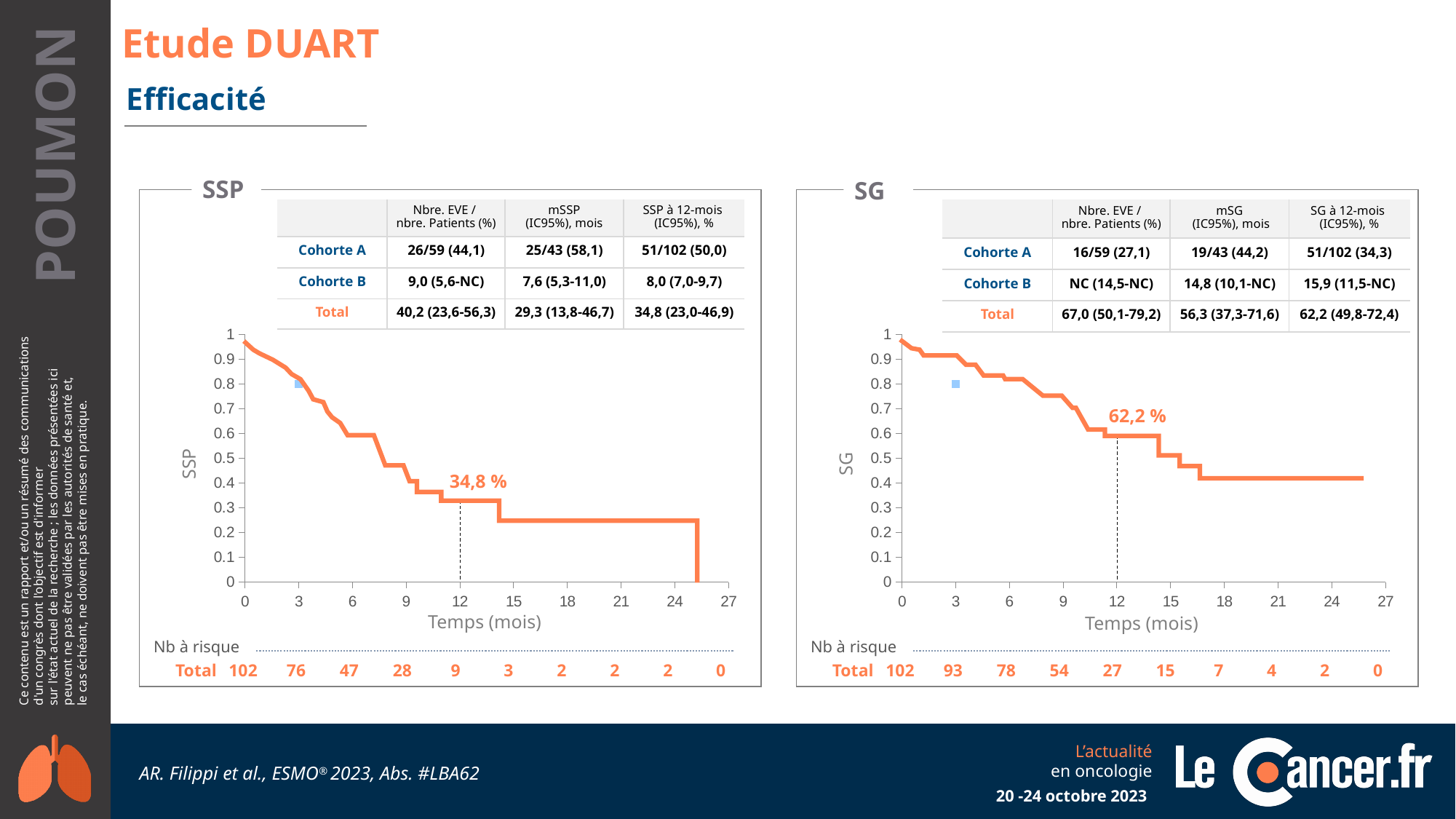
Which chart shows the higher labelled value at 12 months, SSP or SG? SG On the SG chart, what is the number at risk (Nb à risque) at 0 months? 102 What kind of chart is the SG chart? line chart On the SSP chart, what is the number at risk (Nb à risque) at 9 months? 28 On the SSP chart, is the curve value at 6 months greater or less than 0.5? greater On the SSP chart, what value is labelled on the curve at 12 months? 34,8 % What is the x-axis title of the SSP chart? Temps (mois) On the SG chart, is the curve value at 24 months greater or less than 0.5? less On the SSP chart, does the curve rise or fall as time increases along the x axis? fall What is the difference between the 12-month value labelled on the SG chart and the one labelled on the SSP chart? 27,4 % On the SG chart, what is the number at risk (Nb à risque) at 12 months? 27 On the SG chart, what value is labelled on the curve at 12 months? 62,2 %